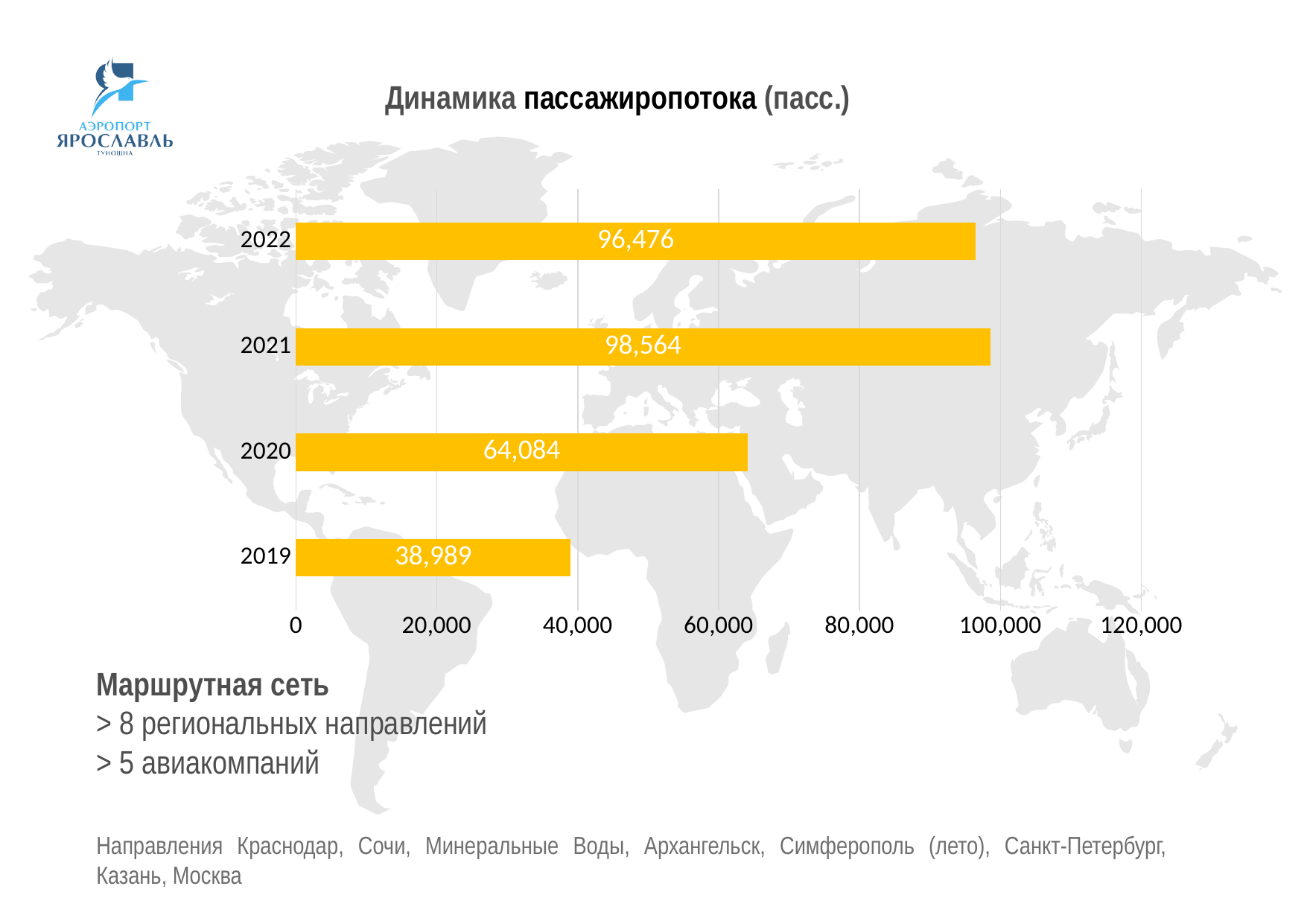
What value is shown for 2020? 64,084 What was the passenger traffic in 2022? 96,476 Which year has the highest passenger traffic? 2021 Is the value for 2020 greater or less than 60,000? greater What is the title of the chart? Динамика пассажиропотока (пасс.) How many years are shown in the chart? 4 What was the passenger traffic in 2019? 38,989 Which year has the lowest passenger traffic? 2019 What type of chart is used on the slide? Bar chart Which year had more passengers, 2020 or 2022? 2022 By how much did passenger traffic grow from 2019 to 2020? 25,095 What is the difference between the 2021 and 2022 values? 2,088